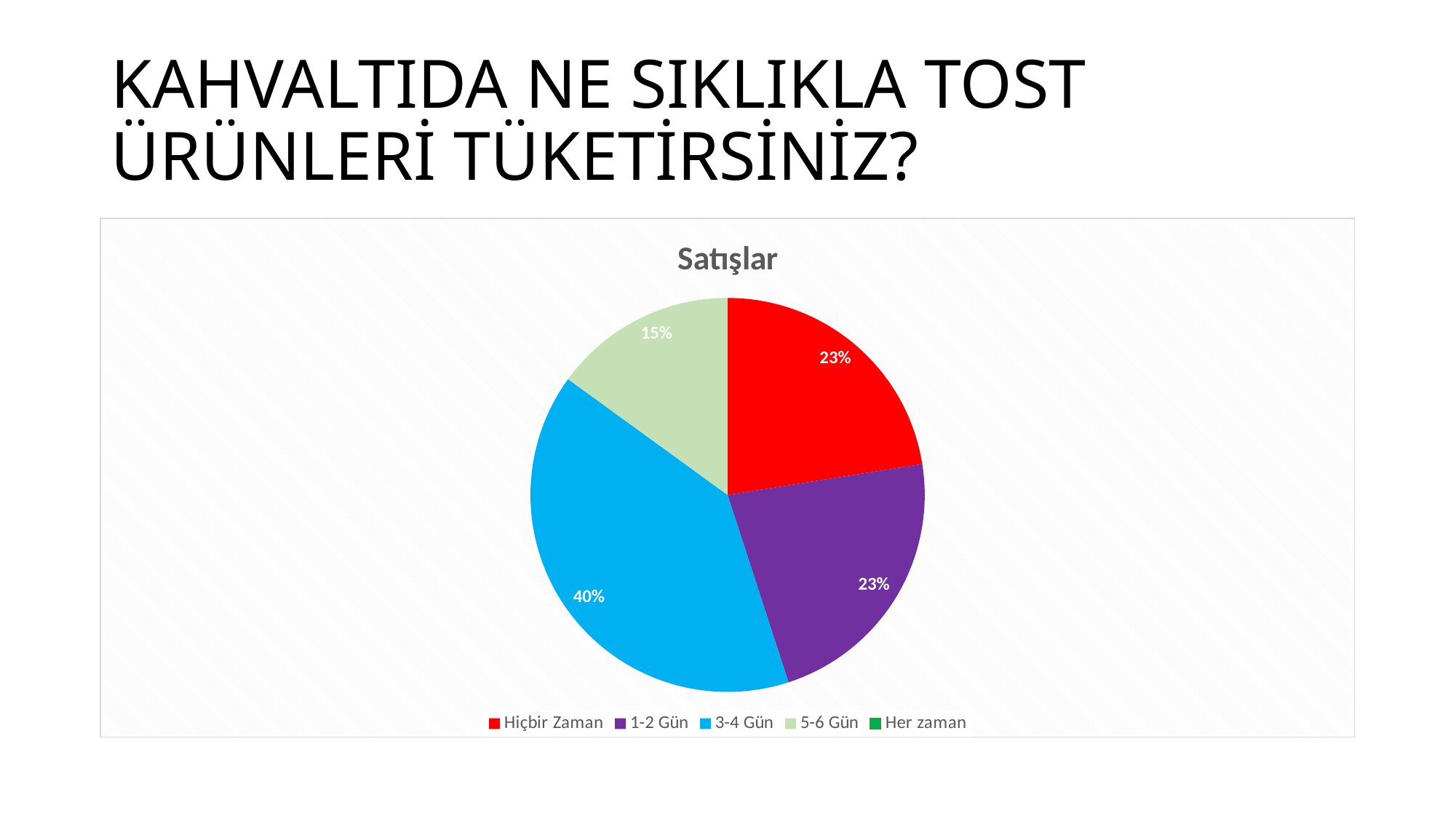
Which slice is larger, 3-4 Gün or Hiçbir Zaman? 3-4 Gün What percentage of the pie does the 1-2 Gün slice represent? 23% What percentage of the pie does the Hiçbir Zaman slice represent? 23% Which slice is larger, 1-2 Gün or 5-6 Gün? 1-2 Gün What percentage of the pie does the 3-4 Gün slice represent? 40% Which category has the largest slice of the pie? 3-4 Gün How many categories does the legend list? 5 What colour is the 3-4 Gün slice? blue What is the difference in percentage points between the 3-4 Gün slice and the 5-6 Gün slice? 25% What kind of chart is shown on the slide? pie chart What percentage of the pie does the 5-6 Gün slice represent? 15% What is the title of the chart? Satışlar